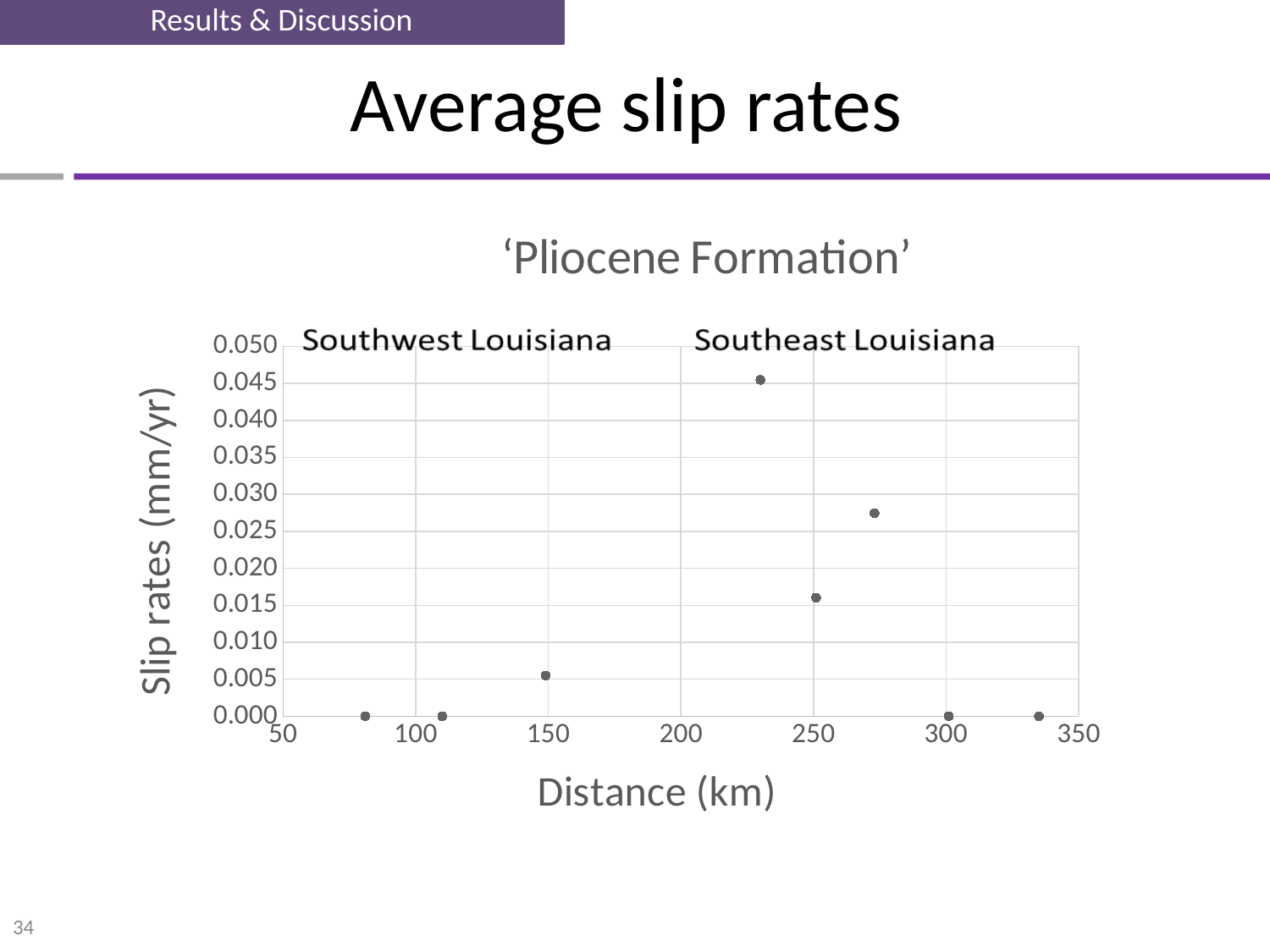
Which has the larger slip rate: the point near 275 km or the point near 150 km? the point near 275 km What is the title of the chart? 'Pliocene Formation' How many data points lie on the 0.000 line of the y axis? 4 What is the label of the y axis? Slip rates (mm/yr) What kind of chart is shown on the slide? scatter chart Is the slip rate of the highest point greater or less than 0.040 mm/yr? greater Which has the larger slip rate: the point near 230 km or the point near 250 km? the point near 230 km Is the slip rate of the point near 250 km greater or less than 0.010 mm/yr? greater Is the slip rate of the point near 275 km greater or less than 0.020 mm/yr? greater Between which two x-axis ticks does the point with the highest slip rate lie? 200 and 250 How many data points are plotted on the chart? 8